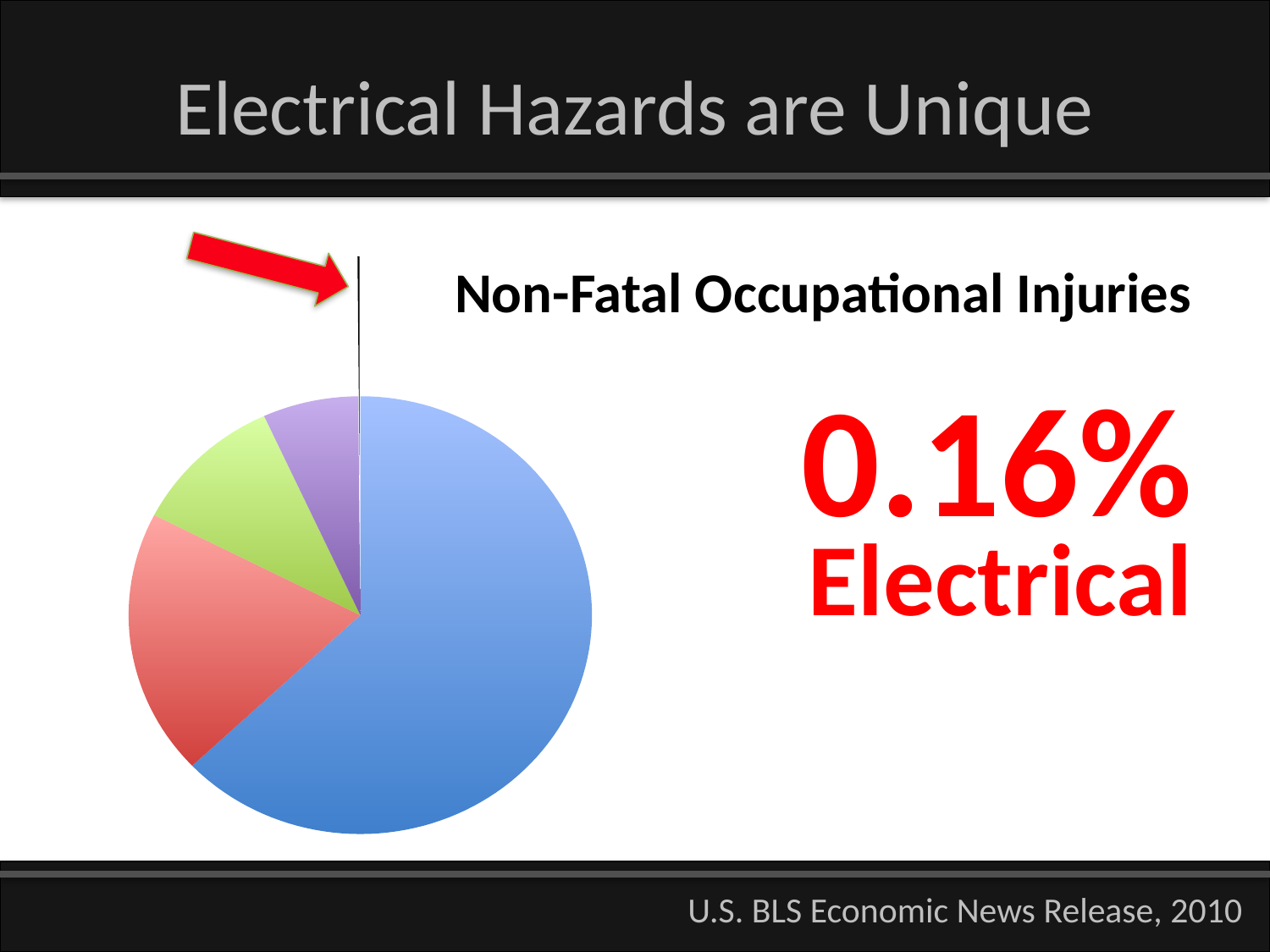
Which category is called out with the red arrow on the pie chart? Electrical Which slice is larger, the blue slice or the red slice? the blue slice What kind of chart is shown on the slide? pie chart Does the blue slice account for more or less than half of the pie? more Which category has the smallest share of the pie chart? Electrical Is the Electrical share of non-fatal occupational injuries greater or less than 1%? less Which slice is larger, the green slice or the purple slice? the green slice Which slice of the pie chart is the largest? the blue slice What share of non-fatal occupational injuries is attributed to Electrical? 0.16% Which slice is larger, the red slice or the green slice? the red slice What source is cited for the chart data? U.S. BLS Economic News Release, 2010 What is the title of the pie chart? Non-Fatal Occupational Injuries